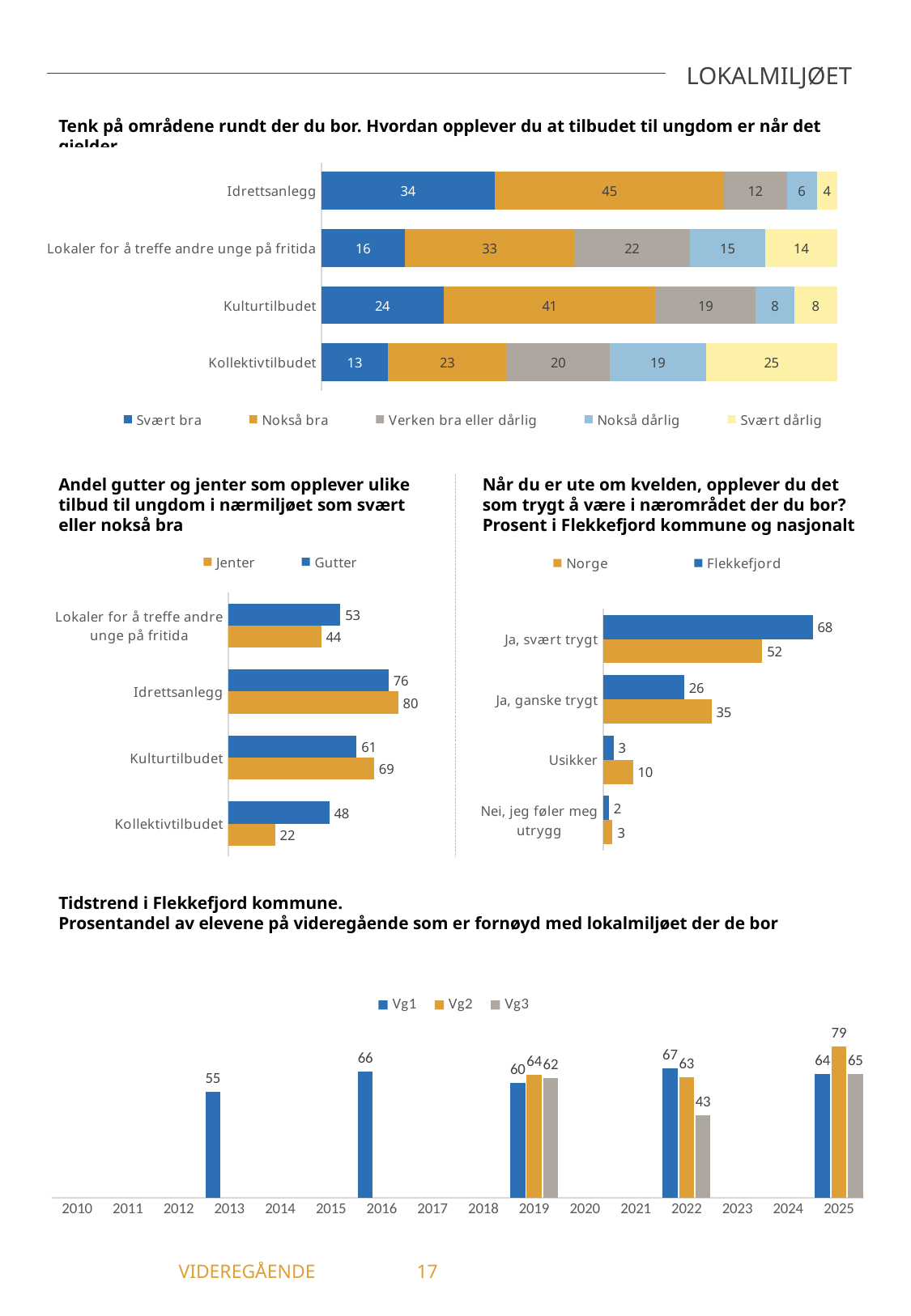
In the chart 'Andel gutter og jenter som opplever ulike tilbud til ungdom i nærmiljøet som svært eller nokså bra', what is the difference between Jenter and Gutter for Kulturtilbudet? 8 What kind of chart is the 'Tidstrend i Flekkefjord kommune' chart? Bar chart In the chart 'Når du er ute om kvelden, opplever du det som trygt å være i nærområdet der du bor?', what is the value for Flekkefjord for 'Ja, svært trygt'? 68 In the top stacked bar chart, how many series does the legend list? 5 In the chart 'Tidstrend i Flekkefjord kommune', how many series does the legend list? 3 In the chart 'Andel gutter og jenter som opplever ulike tilbud til ungdom i nærmiljøet som svært eller nokså bra', what is the value for Gutter for Kollektivtilbudet? 48 In the top stacked bar chart, which category has the highest 'Svært dårlig' value? Kollektivtilbudet In the chart 'Når du er ute om kvelden, opplever du det som trygt å være i nærområdet der du bor?', which is larger for 'Ja, ganske trygt': Norge or Flekkefjord? Norge In the top stacked bar chart, what is the value for 'Svært bra' for Idrettsanlegg? 34 In the chart 'Andel gutter og jenter som opplever ulike tilbud til ungdom i nærmiljøet som svært eller nokså bra', which category has the lowest Jenter value? Kollektivtilbudet In the chart 'Tidstrend i Flekkefjord kommune', what is the value for Vg2 in 2025? 79 In the top stacked bar chart, what is the total of the Kollektivtilbudet bar? 100